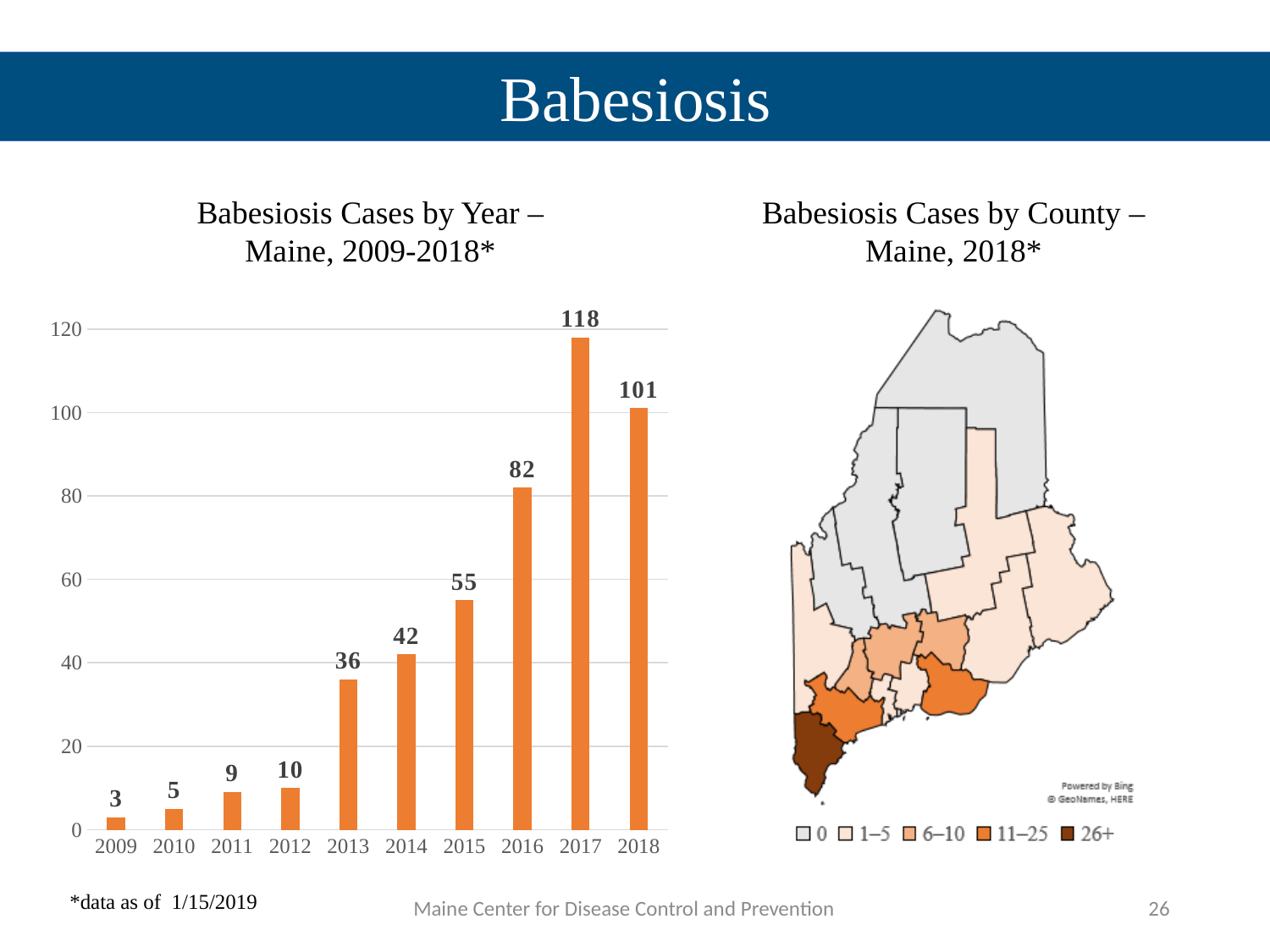
In the 'Babesiosis Cases by Year – Maine, 2009-2018*' chart, do the values generally rise or fall from 2009 to 2017? Rise How many years are shown on the x axis of the 'Babesiosis Cases by Year – Maine, 2009-2018*' chart? 10 In the 'Babesiosis Cases by Year – Maine, 2009-2018*' chart, how many cases were reported in 2017? 118 In the 'Babesiosis Cases by Year – Maine, 2009-2018*' chart, is the value for 2016 greater or less than 80? greater In the 'Babesiosis Cases by Year – Maine, 2009-2018*' chart, which year had more cases, 2014 or 2015? 2015 What kind of chart is 'Babesiosis Cases by Year – Maine, 2009-2018*'? Bar chart In the 'Babesiosis Cases by Year – Maine, 2009-2018*' chart, what is the difference in cases between 2017 and 2018? 17 In the 'Babesiosis Cases by Year – Maine, 2009-2018*' chart, which year has the highest number of cases? 2017 In the 'Babesiosis Cases by Year – Maine, 2009-2018*' chart, what is the difference in cases between 2016 and 2015? 27 In the 'Babesiosis Cases by Year – Maine, 2009-2018*' chart, how many cases were reported in 2013? 36 In the 'Babesiosis Cases by Year – Maine, 2009-2018*' chart, which year has the lowest number of cases? 2009 In the 'Babesiosis Cases by Year – Maine, 2009-2018*' chart, how many cases were reported in 2018? 101